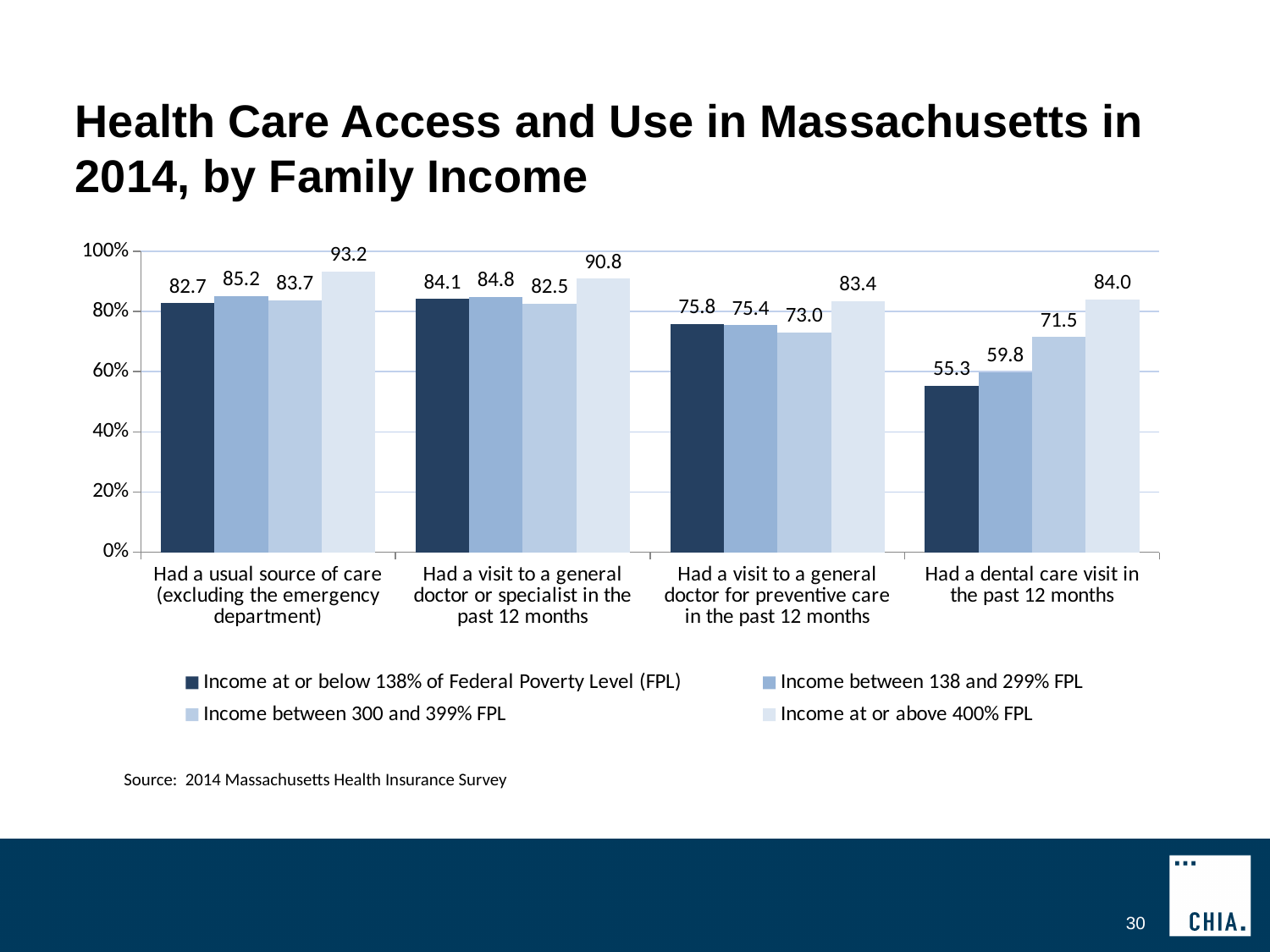
What is the difference between the 'Income at or above 400% FPL' and 'Income at or below 138% of Federal Poverty Level (FPL)' values in the 'Had a dental care visit in the past 12 months' category? 28.7 Which income group has the lowest value in the 'Had a visit to a general doctor or specialist in the past 12 months' category? Income between 300 and 399% FPL What is the value for 'Income between 300 and 399% FPL' in the 'Had a visit to a general doctor for preventive care in the past 12 months' category? 73.0 How many categories are shown on the x axis? 4 What source is cited below the chart? 2014 Massachusetts Health Insurance Survey How many series does the legend list? 4 What kind of chart is shown on the slide? Bar chart Which income group has the highest value in the 'Had a dental care visit in the past 12 months' category? Income at or above 400% FPL Is the value for 'Income between 138 and 299% FPL' in the 'Had a dental care visit in the past 12 months' category greater or less than 60%? less What is the value for 'Income at or above 400% FPL' in the 'Had a usual source of care (excluding the emergency department)' category? 93.2 Which is larger in the 'Had a visit to a general doctor for preventive care in the past 12 months' category: the value for 'Income at or below 138% of Federal Poverty Level (FPL)' or for 'Income between 300 and 399% FPL'? Income at or below 138% of Federal Poverty Level (FPL) What is the value for 'Income at or below 138% of Federal Poverty Level (FPL)' in the 'Had a dental care visit in the past 12 months' category? 55.3